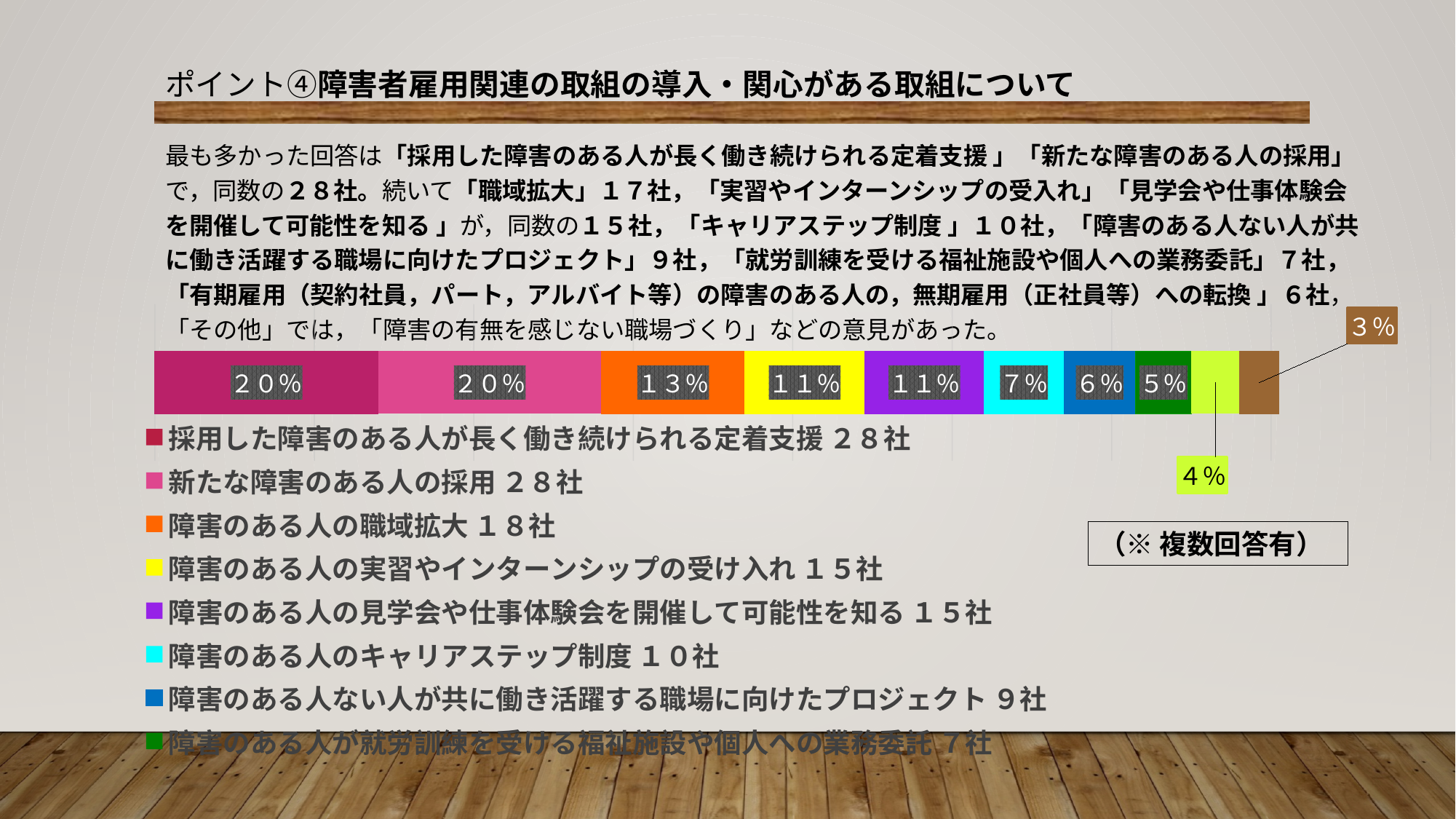
What is the smallest percentage labelled on the bar? 3% What kind of chart is shown on the slide? Stacked bar chart What percentage is shown for 障害のある人のキャリアステップ制度 (the cyan segment)? 7% What percentage is shown for 障害のある人が就労訓練を受ける福祉施設や個人への業務委託 (the green segment)? 5% What percentage is shown for 障害のある人の職域拡大 (the orange segment)? 13% What percentage is shown for 採用した障害のある人が長く働き続けられる定着支援 (the dark pink segment)? 20% Which has the larger percentage: 障害のある人の職域拡大 or 障害のある人の実習やインターンシップの受け入れ? 障害のある人の職域拡大 How many segments make up the stacked bar? 10 What is the difference between the percentage for 新たな障害のある人の採用 and the percentage for 障害のある人の職域拡大? 7% According to the legend, how many companies chose 障害のある人の見学会や仕事体験会を開催して可能性を知る? 15社 What is the largest percentage labelled on the bar? 20% What is the total of all the percentage labels on the stacked bar? 100%